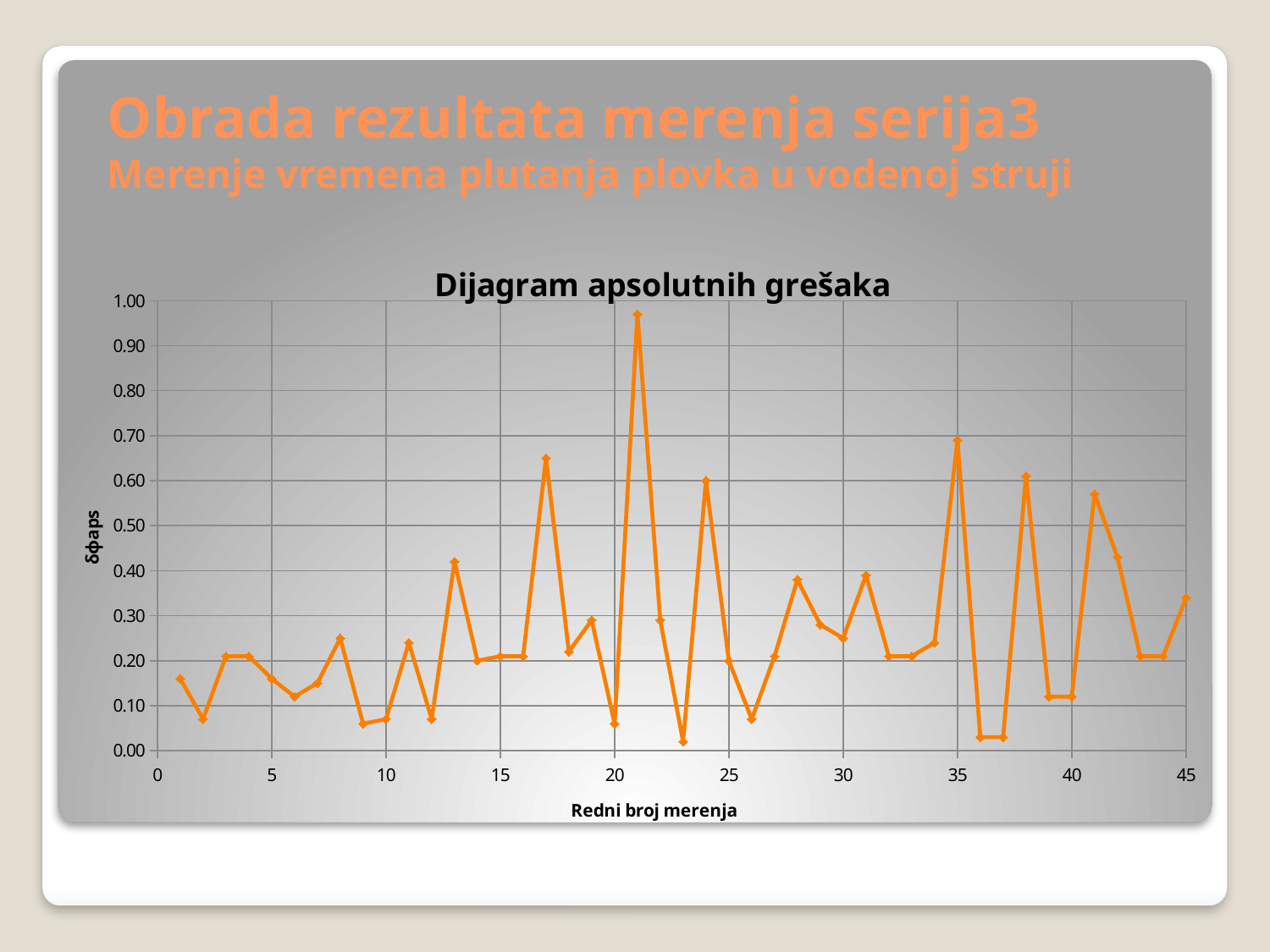
Is the value for measurement 2 greater or less than 0.10? less Is the value for measurement 36 greater or less than 0.10? less What is the label of the x axis of the chart? Redni broj merenja Which measurement number (Redni broj merenja) has the lowest absolute error? 23 Is the value for measurement 35 greater or less than 0.60? greater Which measurement number (Redni broj merenja) has the highest absolute error? 21 What is the title of the chart? Dijagram apsolutnih grešaka What kind of chart is shown on the slide? line chart Which has the larger absolute error, measurement 21 or measurement 35? measurement 21 Which has the larger absolute error, measurement 17 or measurement 23? measurement 17